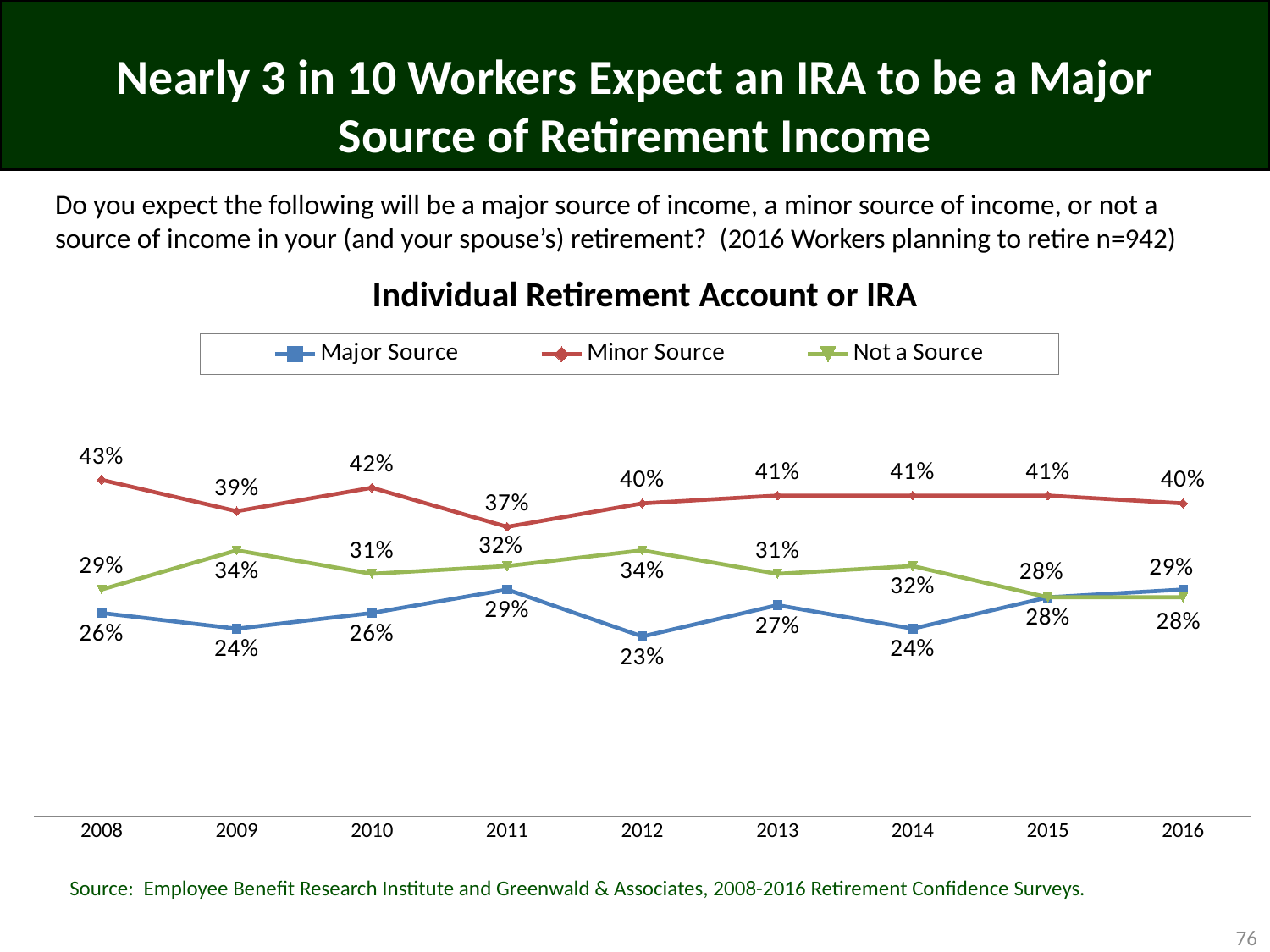
What is the Major Source value for 2016? 29% Does the Major Source value rise or fall from 2014 to 2016? rise How many years are shown on the x axis? 9 Which is larger in 2014, Not a Source or Major Source? Not a Source What is the title of the chart? Individual Retirement Account or IRA What is the Not a Source value for 2012? 34% What is the Minor Source value for 2008? 43% In which year is the Major Source value lowest? 2012 In which year is the Minor Source value highest? 2008 What is the difference between the Minor Source and Major Source values in 2011? 8% How many series does the legend list? 3 What type of chart is shown on the slide? line chart